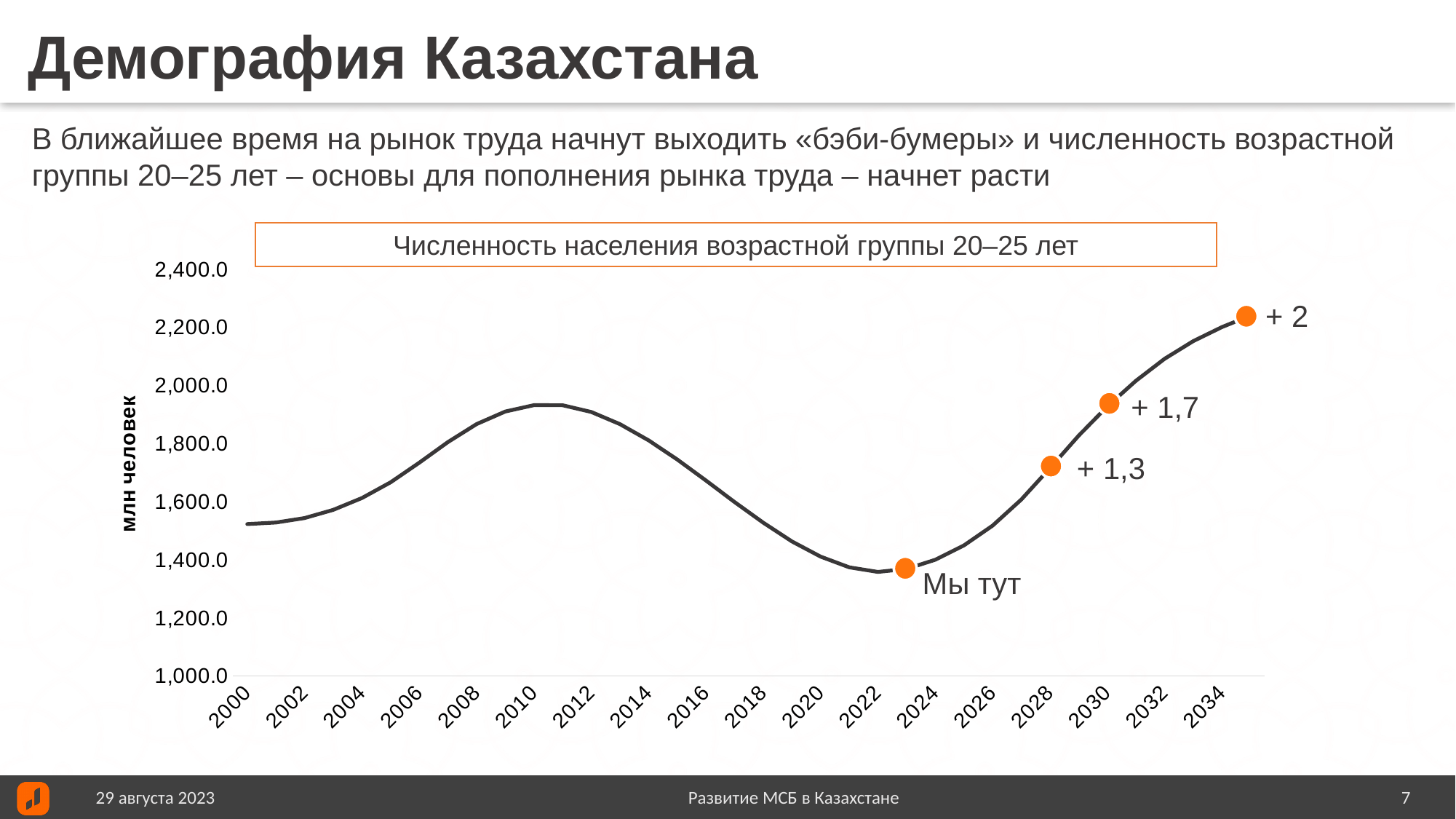
What is the title of the chart? Численность населения возрастной группы 20–25 лет What kind of chart is shown on the slide? line chart Is the value for 2034 greater or less than 2,000.0? greater How many year labels are shown on the horizontal axis? 18 What is the label of the vertical axis of the chart? млн человек Is the value for 2000 greater or less than 1,600.0? less Does the line rise or fall between 2024 and 2034? rise Which year has the larger value, 2010 or 2034? 2034 Is the value for 2022 greater or less than 1,400.0? less Does the line rise or fall between 2010 and 2022? fall Which year has the larger value, 2010 or 2022? 2010